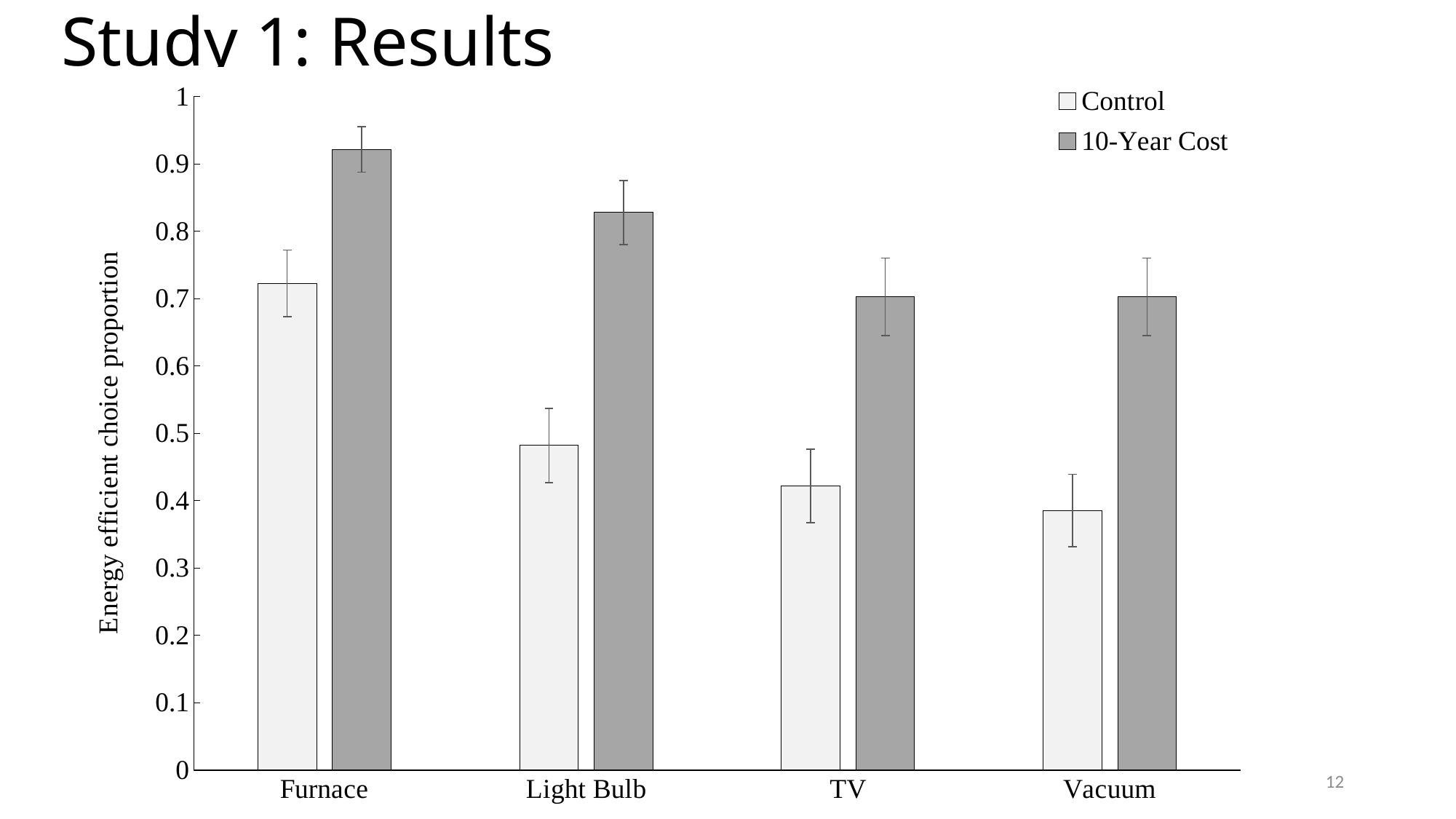
For Light Bulb, which is larger: the Control value or the 10-Year Cost value? 10-Year Cost Is the 10-Year Cost value for TV greater or less than 0.6? greater Which category has the highest Control value? Furnace Is the Control value for TV greater or less than 0.5? less What is the label on the y axis? Energy efficient choice proportion Is the Control value for Vacuum greater or less than 0.3? greater How many series does the legend list? 2 Which category has the lowest Control value? Vacuum How many product categories are shown on the x axis? 4 What kind of chart is shown on the slide? bar chart Which category has the highest 10-Year Cost value? Furnace